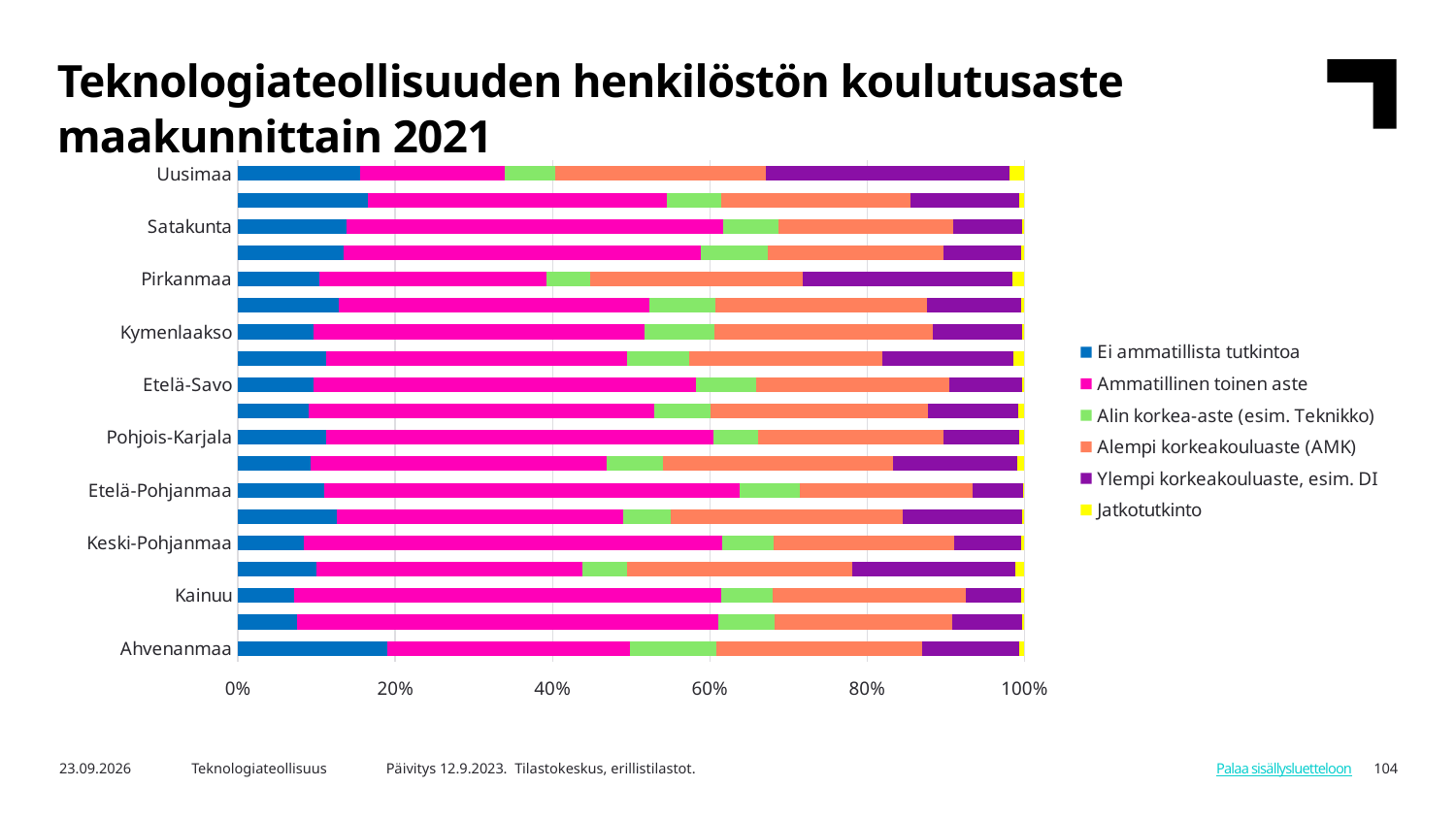
What does each stacked bar total on the x axis? 100% Is the 'Ammatillinen toinen aste' share for Satakunta greater or less than 40%? greater How many series does the legend list? 6 Is the 'Ammatillinen toinen aste' share for Pirkanmaa greater or less than 20%? greater Is the 'Ei ammatillista tutkintoa' share for Uusimaa greater or less than 20%? less What kind of chart is shown on the slide? Stacked bar chart What is the title of the chart? Teknologiateollisuuden henkilöstön koulutusaste maakunnittain 2021 Which has the larger 'Ammatillinen toinen aste' share, Uusimaa or Satakunta? Satakunta Which legend entry is shown in yellow? Jatkotutkinto How many bars (regions) are plotted in the chart? 19